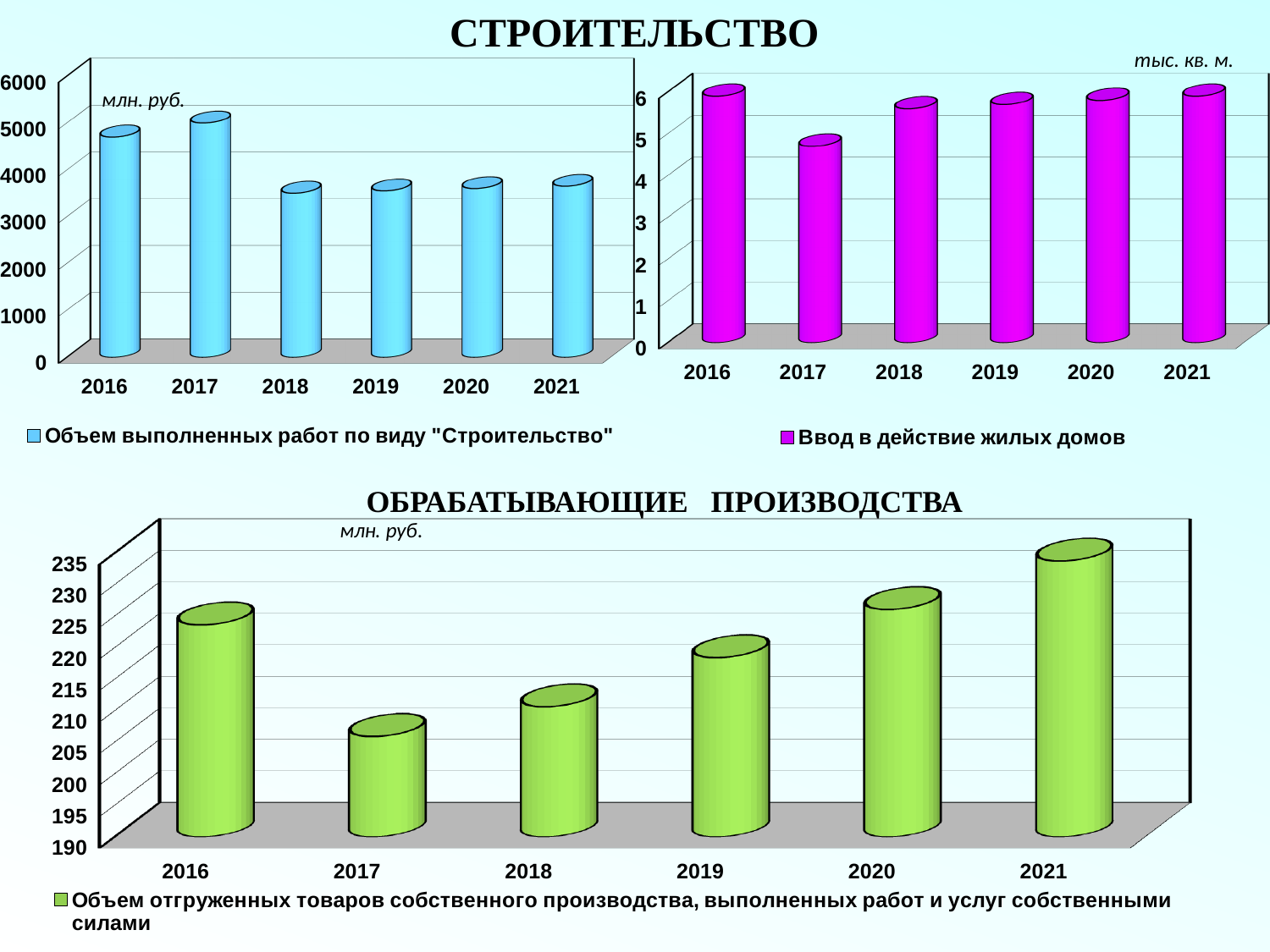
In the top-right chart (Ввод в действие жилых домов), is the value for 2017 greater or less than 5? less In the top-left chart (Объем выполненных работ по виду "Строительство"), is the value for 2018 greater or less than 4000? less In the bottom chart (ОБРАБАТЫВАЮЩИЕ ПРОИЗВОДСТВА), do the values rise or fall from 2017 to 2021? rise In the top-left chart (Объем выполненных работ по виду "Строительство"), which is larger, the value for 2017 or the value for 2020? 2017 In the bottom chart (ОБРАБАТЫВАЮЩИЕ ПРОИЗВОДСТВА), which year has the highest value? 2021 In the bottom chart (ОБРАБАТЫВАЮЩИЕ ПРОИЗВОДСТВА), which year has the lowest value? 2017 In the top-right chart (Ввод в действие жилых домов), how many years are shown on the x axis? 6 In the top-right chart (Ввод в действие жилых домов), which year has the lowest value? 2017 What kind of chart is the bottom chart (ОБРАБАТЫВАЮЩИЕ ПРОИЗВОДСТВА)? bar chart In the top-left chart (Объем выполненных работ по виду "Строительство"), is the value for 2016 greater or less than 4000? greater In the top-left chart (Объем выполненных работ по виду "Строительство"), which year has the highest value? 2017 In the top-right chart (Ввод в действие жилых домов), what unit is shown above the chart? тыс. кв. м.